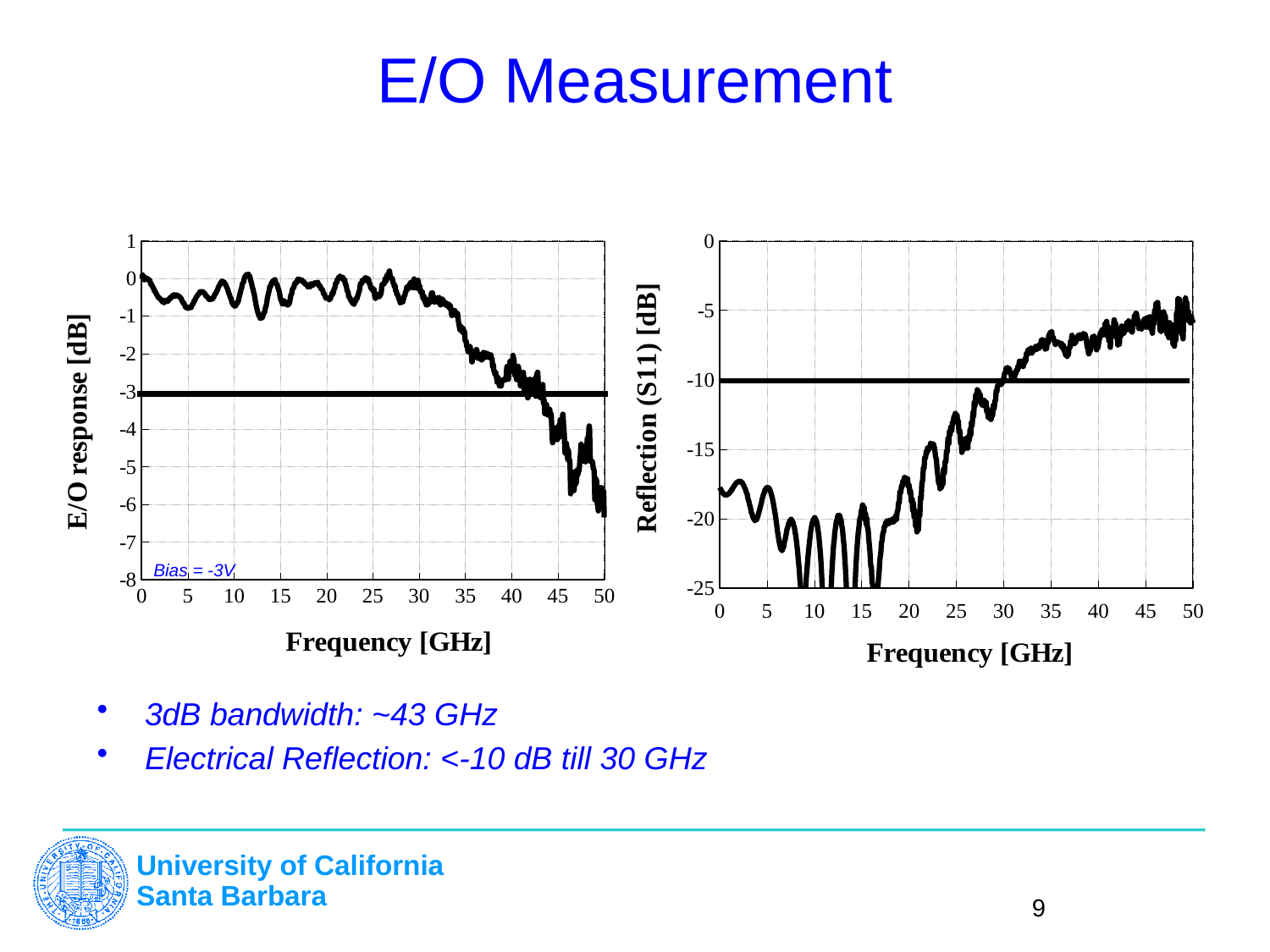
On the right chart, is the reflection at 40 GHz greater or less than -10 dB? greater What kind of chart is the right chart, Reflection (S11) vs Frequency? Line chart On the left chart, is the E/O response at 45 GHz greater or less than -3 dB? less On the right chart, does the reflection overall rise or fall as frequency increases from 15 GHz to 50 GHz? rise On the right chart, is the reflection at 10 GHz greater or less than -15 dB? less On the left chart, does the E/O response overall rise or fall as frequency increases from 30 GHz to 50 GHz? fall On the left chart, what is the label of the y-axis? E/O response [dB] On the right chart, at what y-axis value is the horizontal reference line drawn? -10 On the left chart, at what y-axis value is the horizontal reference line drawn? -3 On the right chart, what is the label of the y-axis? Reflection (S11) [dB] What kind of chart is the left chart, E/O response vs Frequency? Line chart